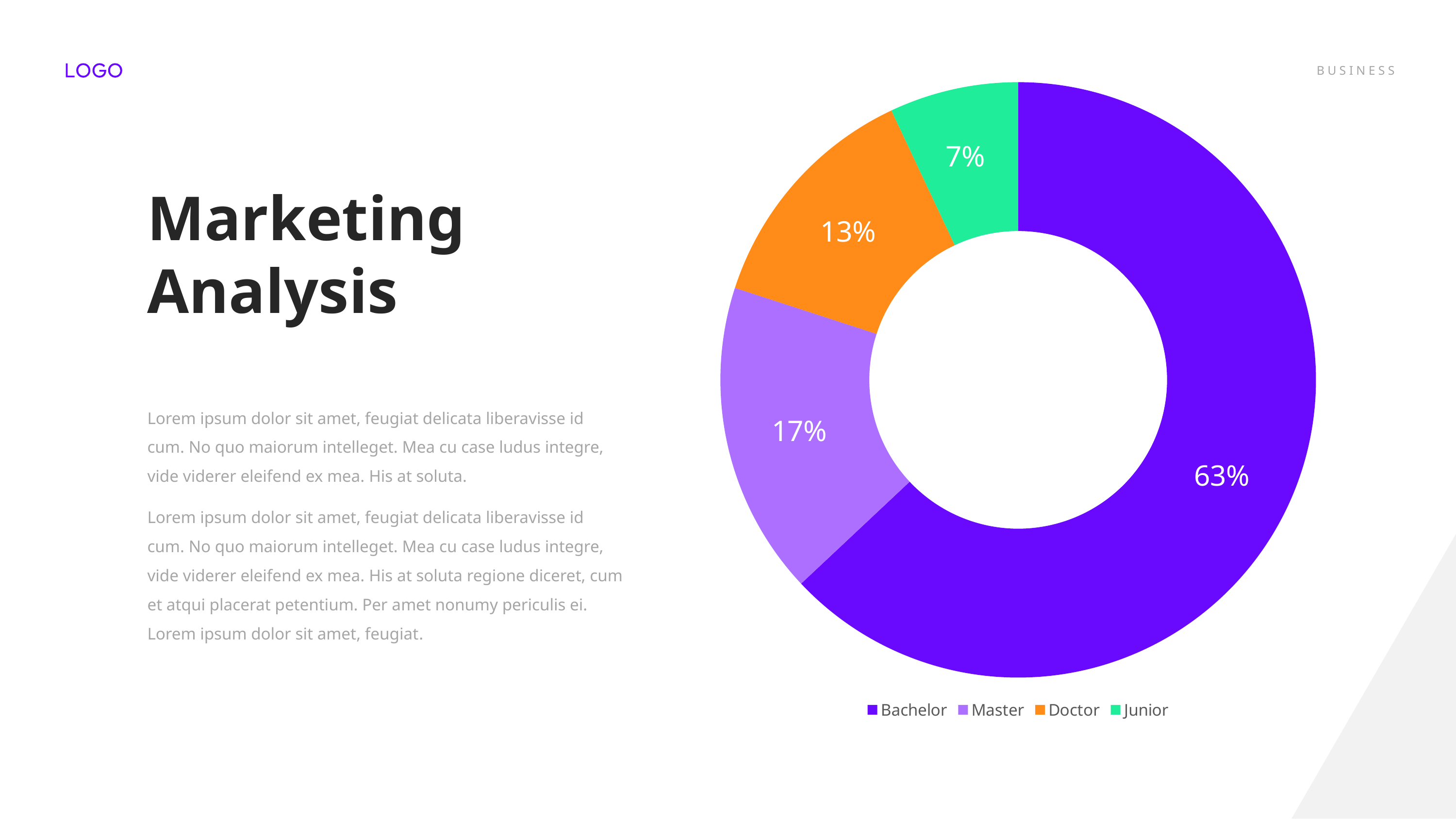
What share of the doughnut chart does Doctor represent? 13% What share of the doughnut chart does Junior represent? 7% Which slice is larger, Master or Doctor? Master What is the difference in percentage points between the Doctor and Junior slices? 6 What share of the doughnut chart does Master represent? 17% Which category has the largest slice in the chart? Bachelor What colour is the Doctor slice in the chart? Orange How many categories does the chart show? 4 What is the difference in percentage points between the Bachelor and Master slices? 46 Which category has the smallest slice in the chart? Junior What share of the doughnut chart does Bachelor represent? 63% What kind of chart is shown on the slide? Doughnut chart